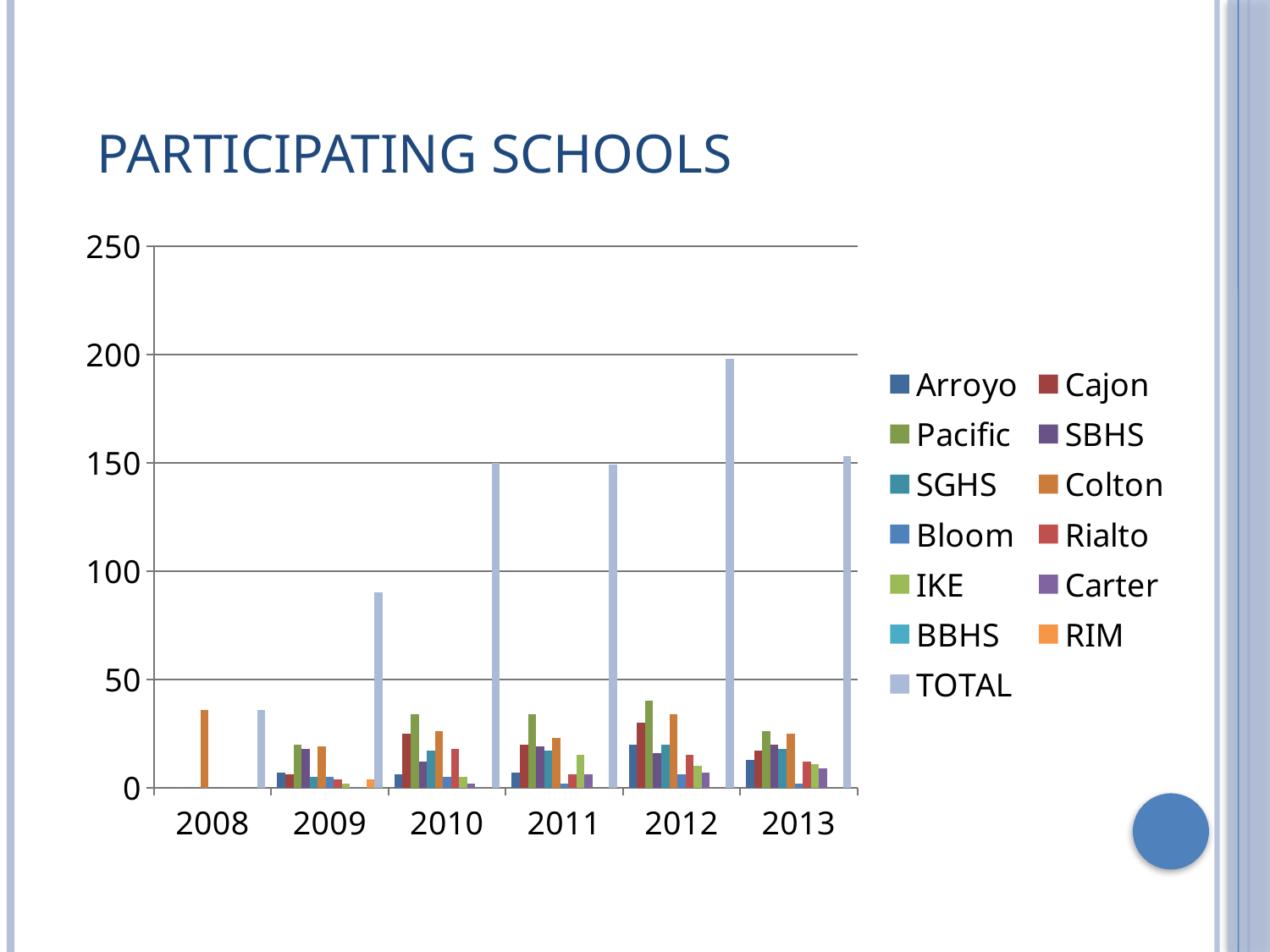
How many series does the legend list? 13 Is the TOTAL value for 2008 greater or less than 50? less What is the title of the chart? PARTICIPATING SCHOOLS Is the TOTAL value for 2012 greater or less than 150? greater Is the TOTAL value for 2009 greater or less than 100? less What kind of chart is shown on the slide? bar chart Which year has a larger TOTAL value, 2008 or 2010? 2010 Does the TOTAL value rise or fall from 2008 to 2012? rise How many years are shown on the x axis of the chart? 6 Which year has a larger TOTAL value, 2009 or 2012? 2012 In which year is the TOTAL bar the highest? 2012 In which year is the TOTAL bar the lowest? 2008